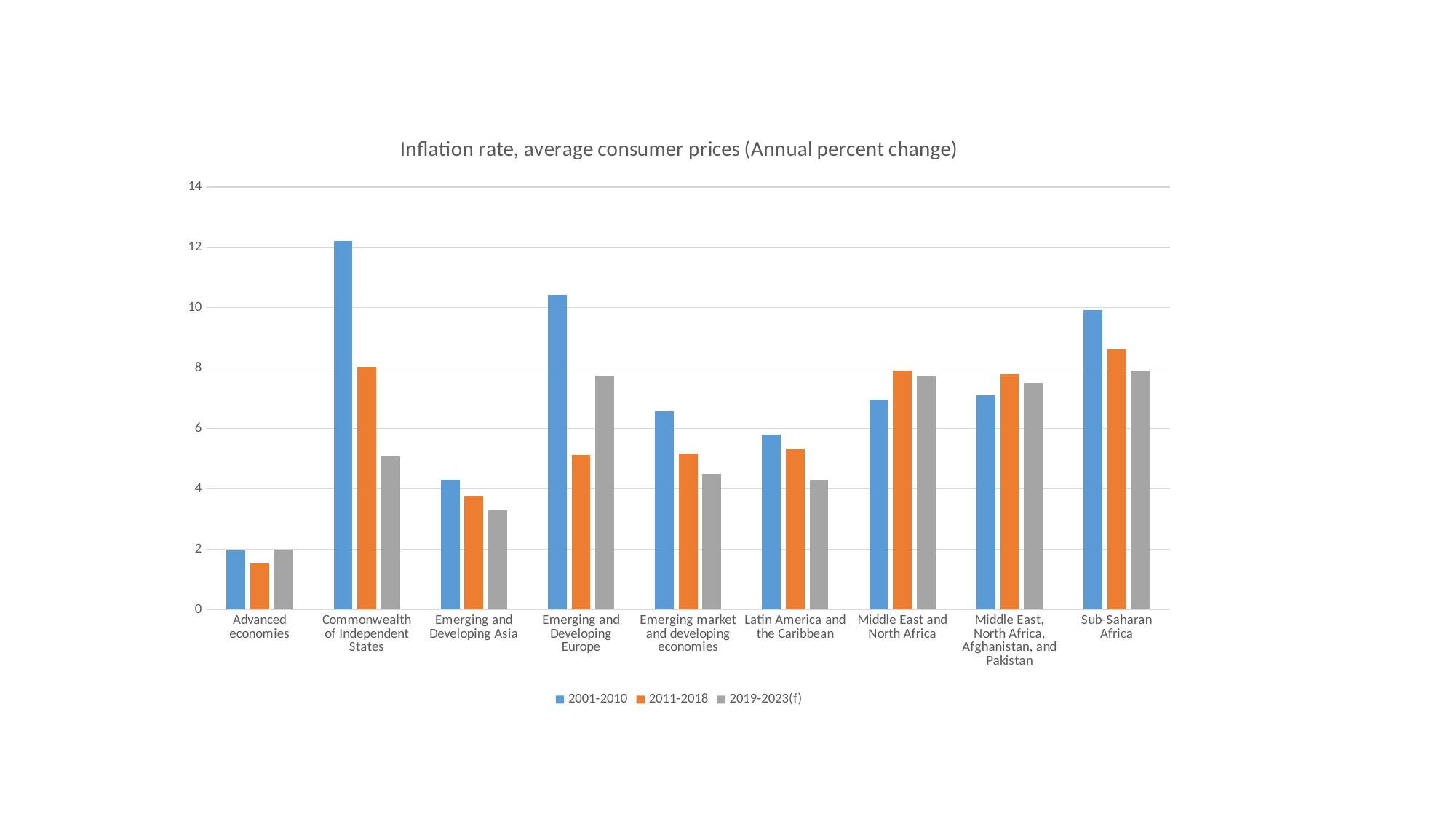
What kind of chart is shown on the slide? bar chart For the 2001-2010 series, which is larger: Commonwealth of Independent States or Sub-Saharan Africa? Commonwealth of Independent States Which category has the lowest value for the 2001-2010 series? Advanced economies Is the 2011-2018 value for Advanced economies greater or less than 2? less How many series does the legend list? 3 For Emerging and Developing Europe, which series has the larger value: 2011-2018 or 2019-2023(f)? 2019-2023(f) Which category has the highest value for the 2011-2018 series? Sub-Saharan Africa Which category has the highest value for the 2001-2010 series? Commonwealth of Independent States What is the title of the chart? Inflation rate, average consumer prices (Annual percent change) How many regional categories are shown on the x axis? 9 Is the 2019-2023(f) value for Emerging and Developing Europe greater or less than 6? greater Is the 2001-2010 value for Commonwealth of Independent States greater or less than 10? greater